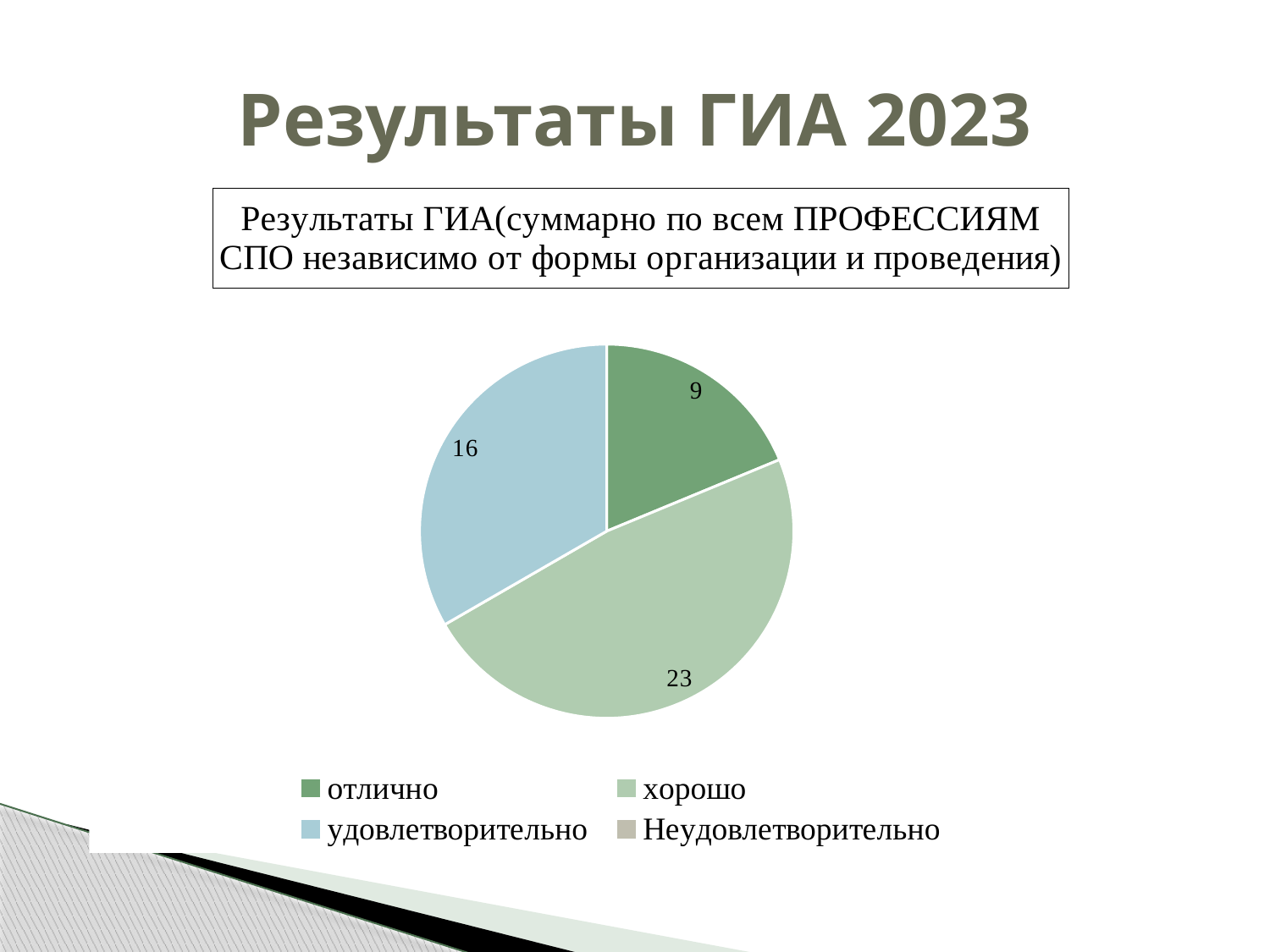
Which of the three visible slices is the smallest? отлично What is the value for the "хорошо" slice? 23 Which category has the largest slice of the pie? хорошо What is the value for the "удовлетворительно" slice? 16 What is the title shown above the pie chart? Результаты ГИА(суммарно по всем ПРОФЕССИЯМ СПО независимо от формы организации и проведения) What kind of chart is shown on the slide? pie chart Which is larger, the value for "отлично" or the value for "удовлетворительно"? удовлетворительно What is the difference between the values for "хорошо" and "отлично"? 14 How many slices with data labels are visible in the pie? 3 How many entries does the legend list? 4 What is the difference between the values for "хорошо" and "удовлетворительно"? 7 What is the value for the "отлично" slice? 9